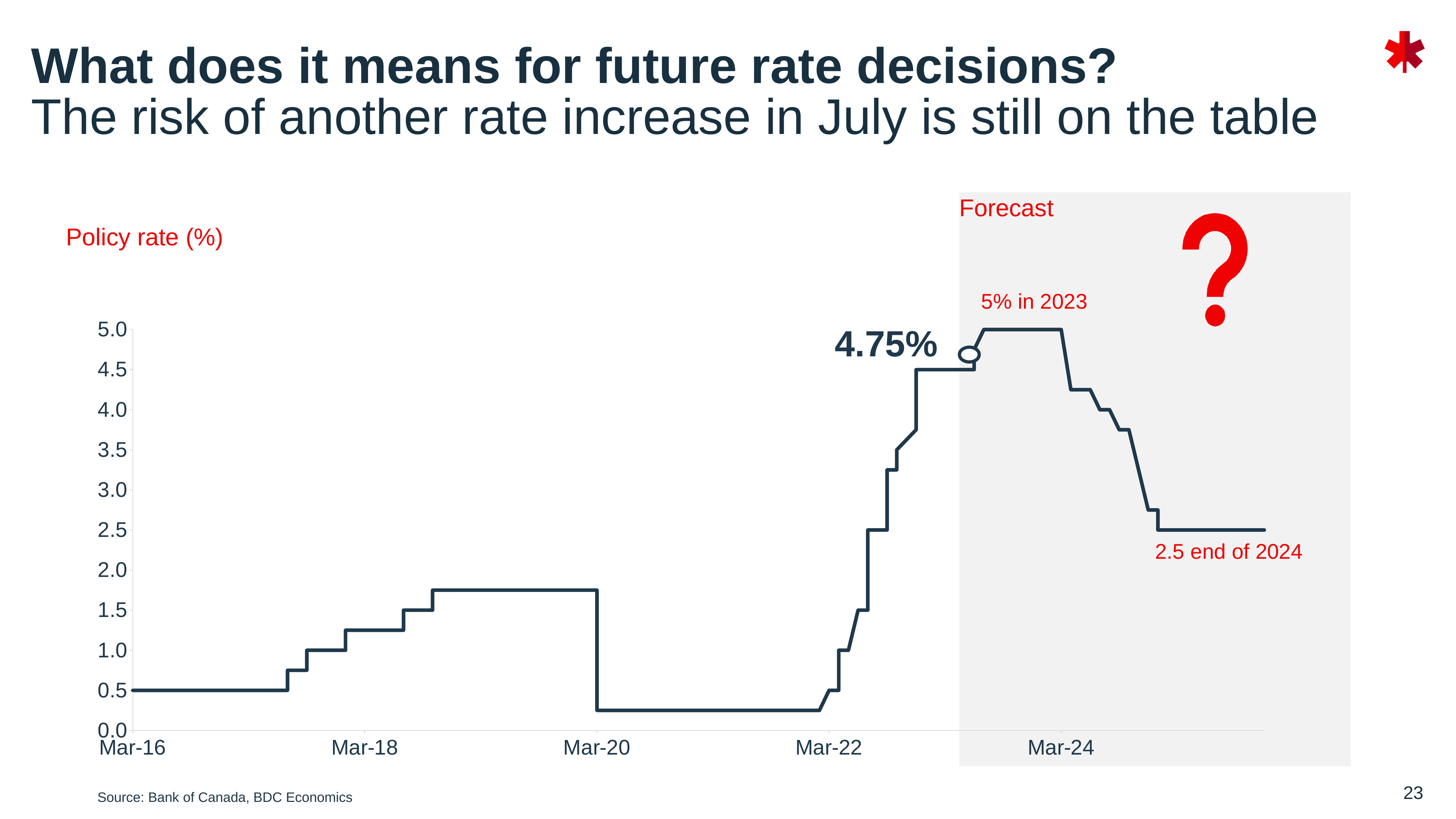
What kind of chart is shown on the slide? line chart What policy rate does the forecast show for the end of 2024? 2.5 What is the highest policy rate reached on the chart? 5% What policy rate does the forecast show for 2023? 5% What label is given to the shaded area on the right of the chart? Forecast Which is higher, the policy rate at Mar-18 or at Mar-22? Mar-18 What is the difference between the forecast 5% peak in 2023 and the 2.5 forecast for the end of 2024? 2.5 percentage points Does the policy rate rise or fall between Mar-22 and Mar-24? rise What is the current policy rate labelled on the chart? 4.75% Is the policy rate at Mar-16 greater or less than 1.0? less By how much is the forecast 2023 peak of 5% above the current 4.75% rate? 0.25 percentage points Is the policy rate at Mar-24 greater or less than 3.0? greater